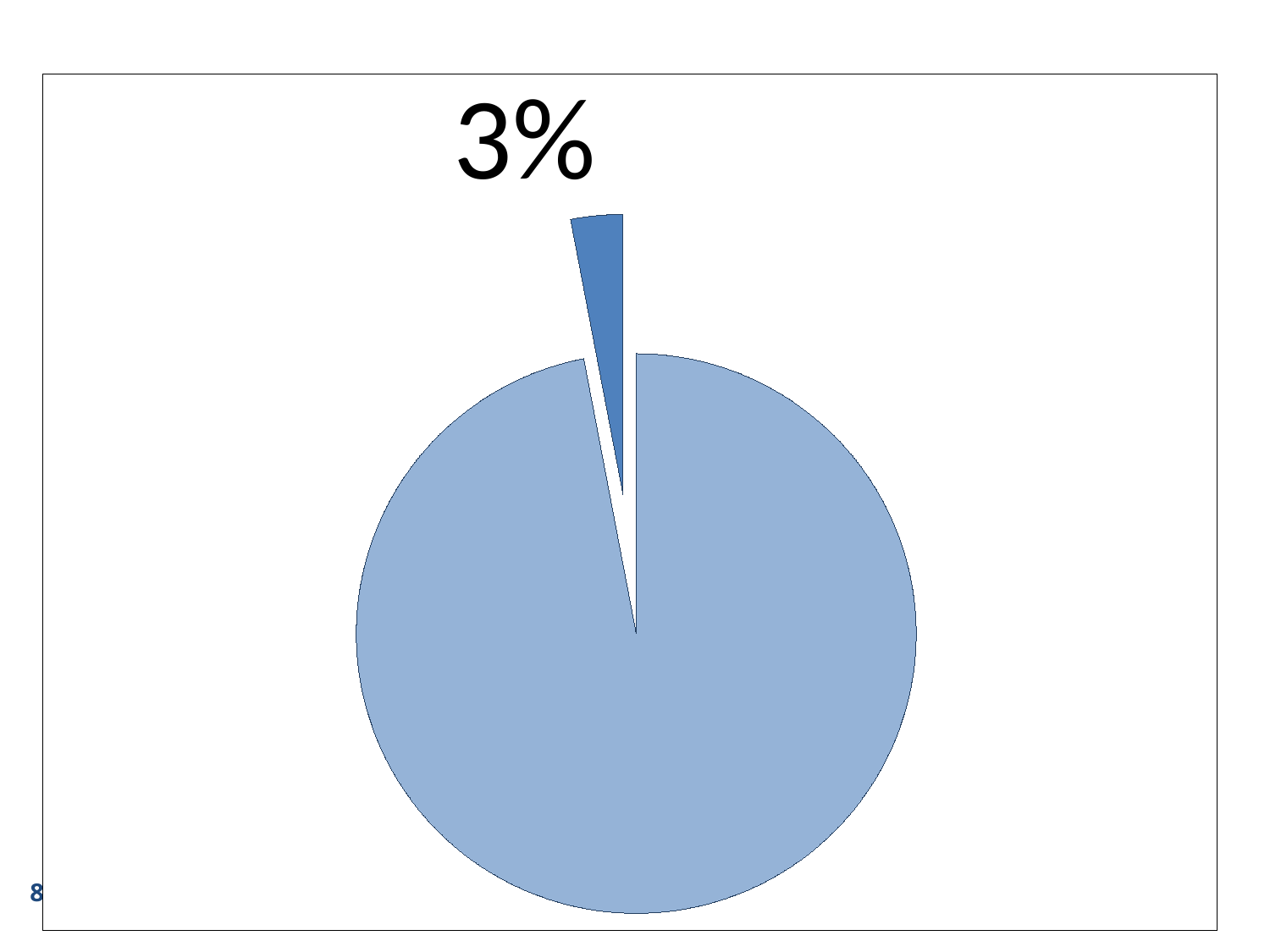
How many slices does the pie chart have? 2 What kind of chart is shown on the slide? pie chart What share of the pie does the small dark blue slice represent? 3% Does the pie chart display a legend? No What colour is the small slice that is pulled out from the pie? dark blue What percentage is printed as the data label on the small, pulled-out slice of the pie chart? 3% Which slice of the pie chart is the smallest? the dark blue slice labelled 3% Which slice of the pie chart is larger, the light blue slice or the dark blue slice? the light blue slice